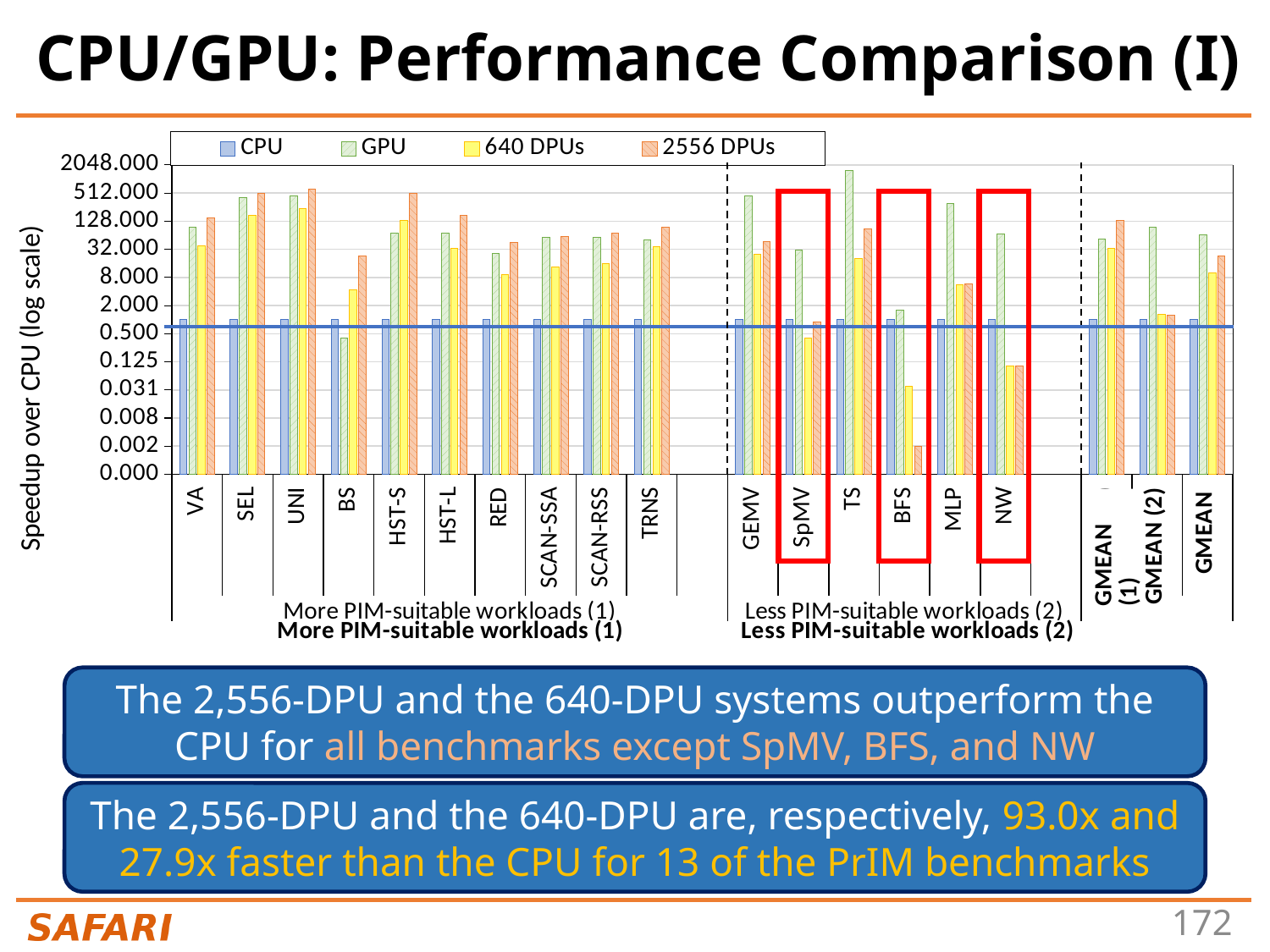
Is the GPU value for TS greater or less than 512.000? greater What is the label of the chart's vertical axis? Speedup over CPU (log scale) What kind of chart is shown on the slide? bar chart Which benchmark has the highest GPU speedup in the chart? TS For SpMV, which is larger: the GPU value or the 640 DPUs value? GPU Is the 640 DPUs value for NW greater or less than 0.500? less What are the four series listed in the chart legend? CPU, GPU, 640 DPUs, 2556 DPUs Is the 2556 DPUs value for SEL greater or less than 128.000? greater How many benchmark categories are shown along the x axis of the chart, including the GMEAN entries? 19 For TS, which is larger: the GPU value or the 2556 DPUs value? GPU How many series does the chart legend list? 4